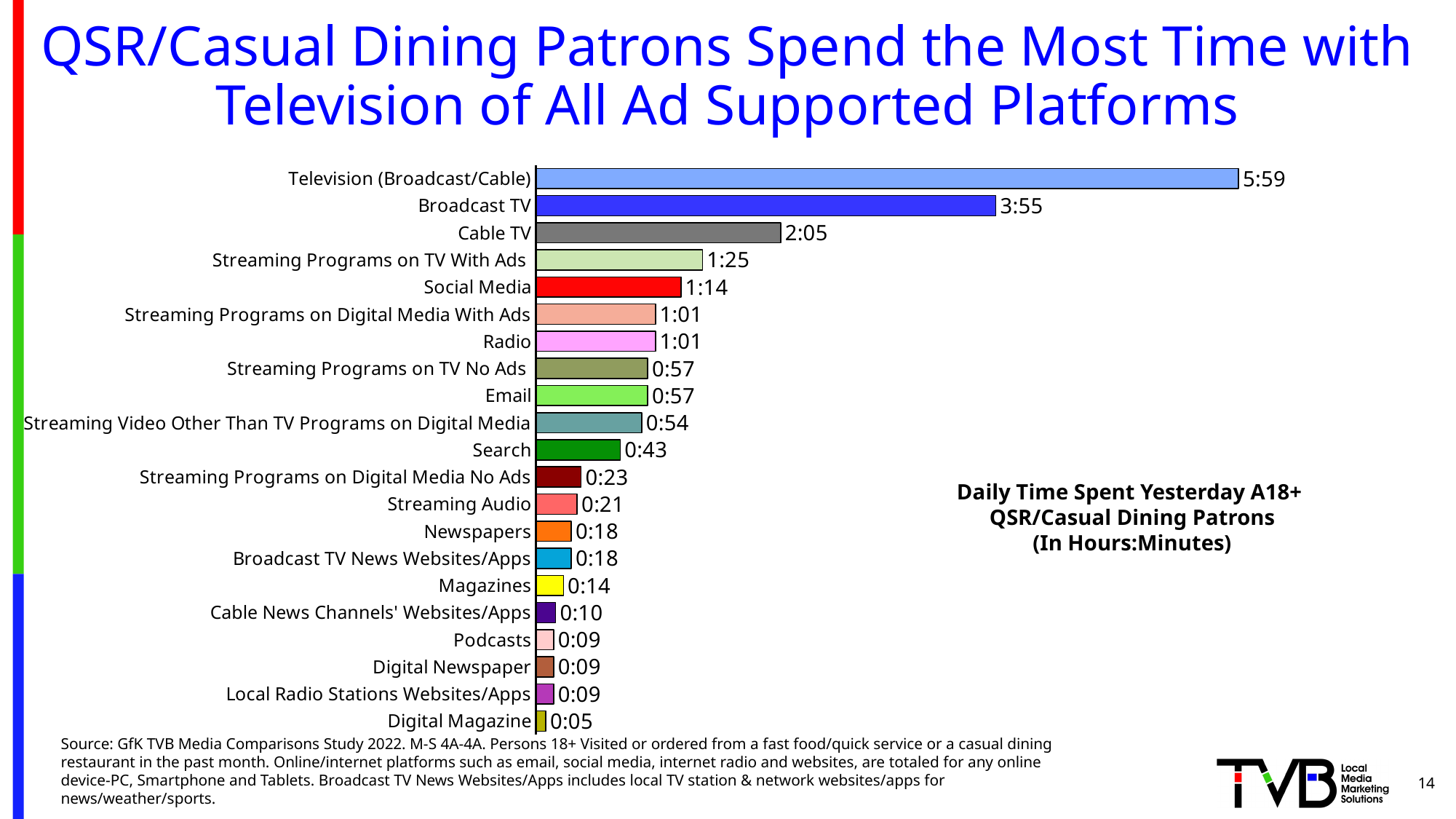
How many platforms are shown in the chart? 21 How much more daily time is spent with Broadcast TV than with Cable TV? 1:50 Which platform has the highest daily time spent? Television (Broadcast/Cable) What is the daily time spent with Social Media? 1:14 What is the daily time spent with Search? 0:43 Which platform has the lowest daily time spent? Digital Magazine Which has a higher daily time spent, Social Media or Radio? Social Media What type of chart is shown on the slide? Bar chart What is the difference in daily time spent between Television (Broadcast/Cable) and Broadcast TV? 2:04 What is the daily time spent with Podcasts? 0:09 What is the daily time spent with Television (Broadcast/Cable)? 5:59 In what units are the values in the chart expressed? Hours:Minutes